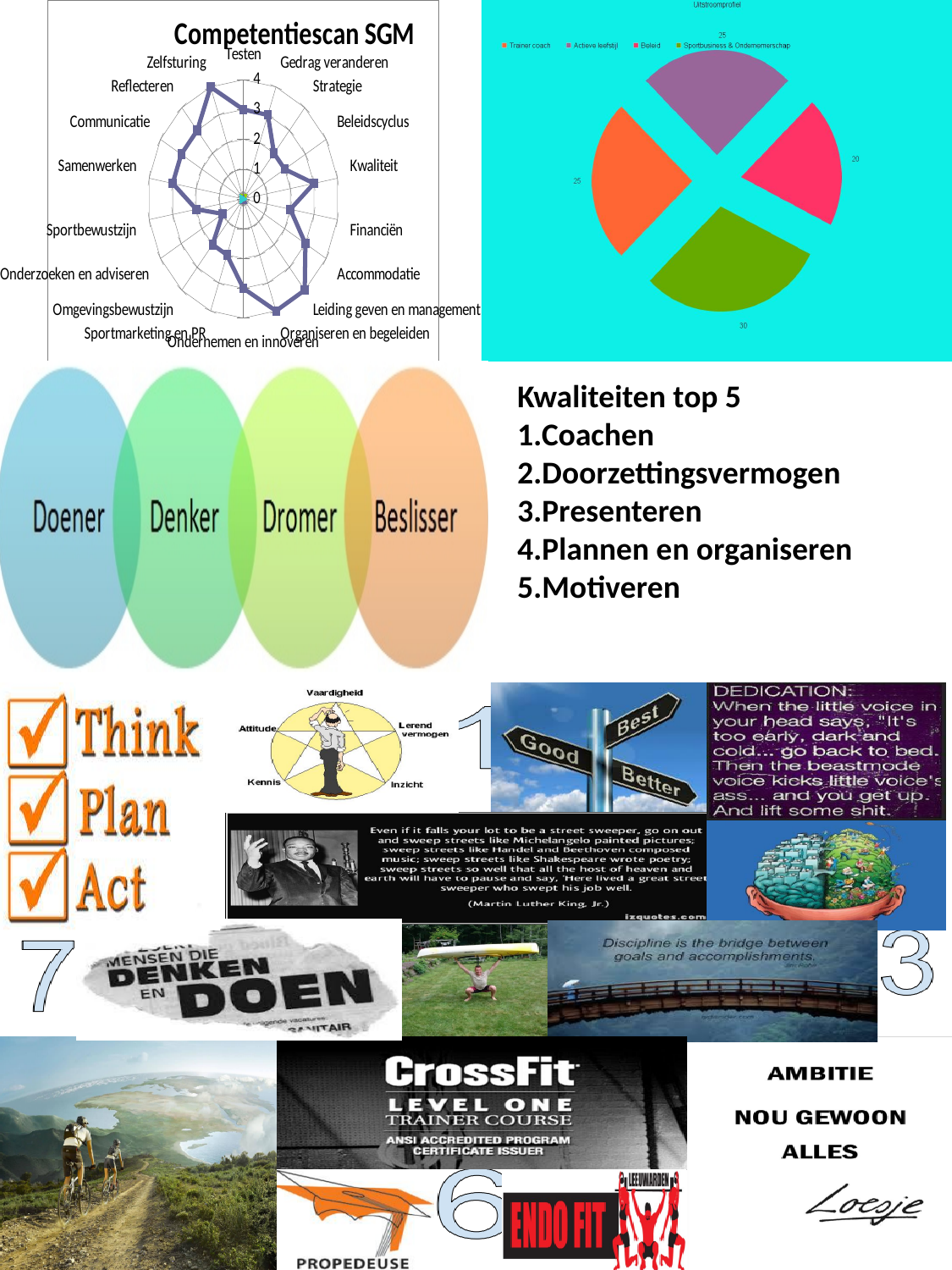
In the 'Uitstroomprofiel' pie chart, what is the value of the largest slice? 30 What kind of chart is the 'Competentiescan SGM' chart? radar chart In the 'Uitstroomprofiel' pie chart, what is the total of all slice values? 100 In the 'Uitstroomprofiel' pie chart, what is the value of the smallest slice? 20 In the 'Competentiescan SGM' radar chart, what is the maximum value shown on the axis scale? 4 In the 'Uitstroomprofiel' pie chart, what is the difference between the largest slice and the smallest slice? 10 In the 'Competentiescan SGM' radar chart, is the value for Kwaliteit greater or less than 2? greater What kind of chart is the 'Uitstroomprofiel' chart? pie chart How many entries does the legend of the 'Uitstroomprofiel' pie chart list? 4 In the 'Uitstroomprofiel' pie chart, how many slices are there? 4 In the 'Uitstroomprofiel' pie chart, what share of the total does the slice labelled 30 represent? 30%